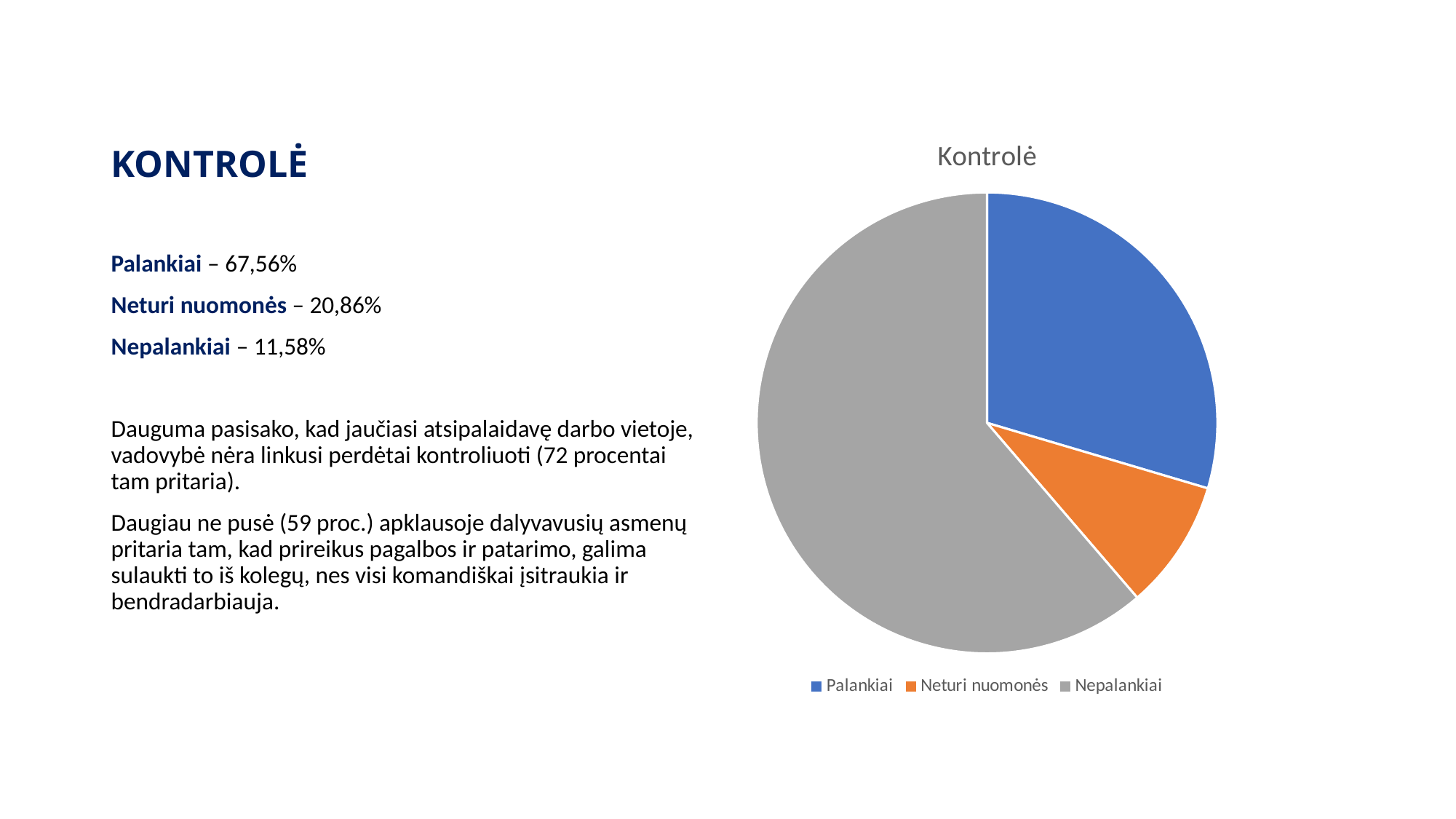
Is the Nepalankiai slice greater or less than half of the pie? greater In the pie chart, which slice is larger: Palankiai or Neturi nuomonės? Palankiai What colour is the Neturi nuomonės slice in the pie chart? orange How many entries does the chart legend list? 3 Is the Palankiai slice greater or less than half of the pie? less How many slices does the pie chart have? 3 In the pie chart, which slice is larger: Nepalankiai or Palankiai? Nepalankiai What is the title of the chart? Kontrolė Which category has the largest slice in the pie chart? Nepalankiai What kind of chart is shown on the slide? pie chart Which category has the smallest slice in the pie chart? Neturi nuomonės